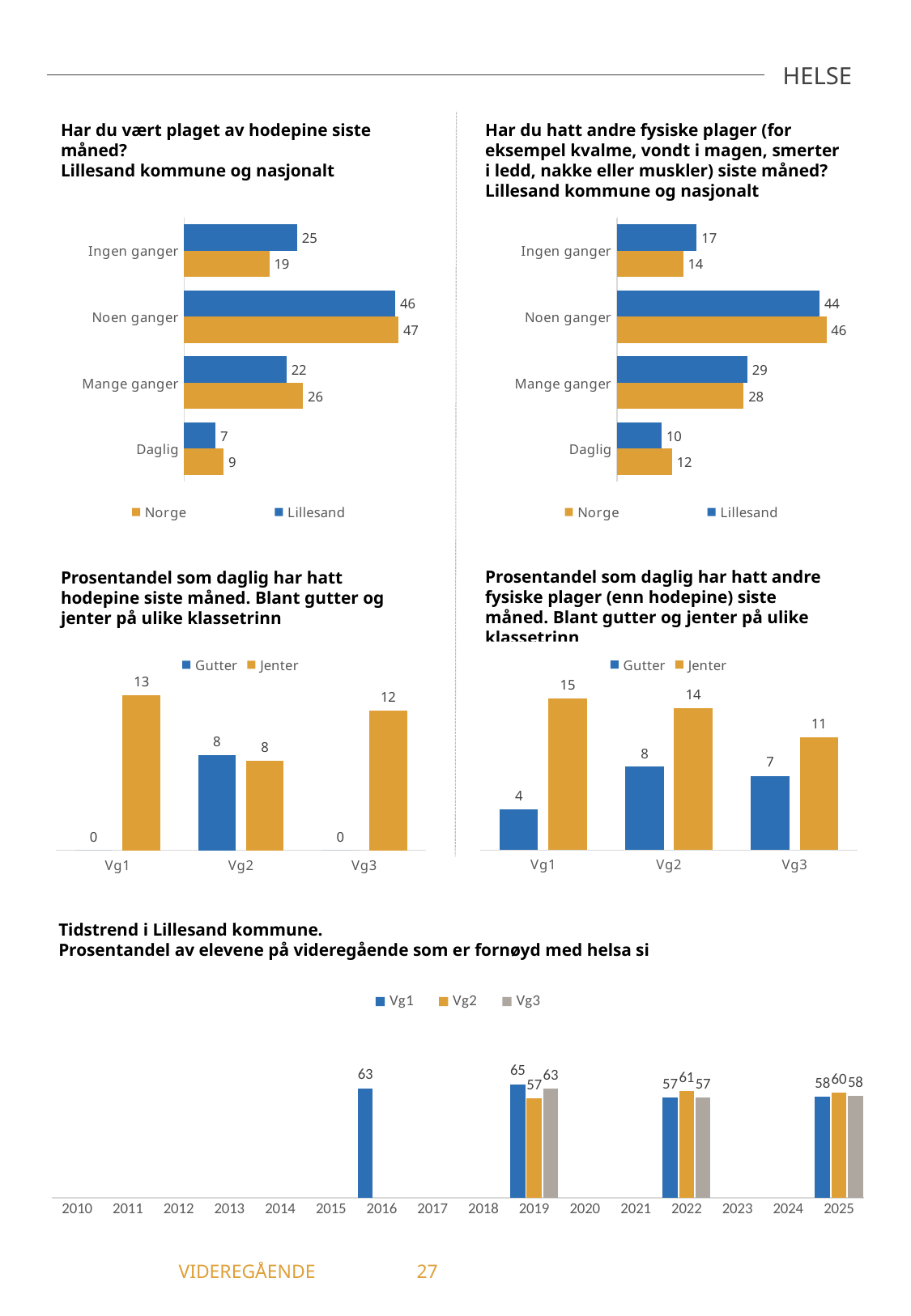
In the middle-right chart 'Prosentandel som daglig har hatt andre fysiske plager', what is the difference between Jenter and Gutter at Vg2? 6 In the top-left chart 'Har du vært plaget av hodepine siste måned?', what is the value for Lillesand in the 'Noen ganger' category? 46 In the middle-right chart 'Prosentandel som daglig har hatt andre fysiske plager', which class level has the lowest value for Gutter? Vg1 In the middle-left chart 'Prosentandel som daglig har hatt hodepine siste måned', what is the value for Jenter at Vg1? 13 In the middle-left chart 'Prosentandel som daglig har hatt hodepine siste måned', how many series does the legend list? 2 What kind of chart is the bottom chart 'Tidstrend i Lillesand kommune'? bar chart In the top-right chart 'Har du hatt andre fysiske plager...', what is the value for Norge in the 'Daglig' category? 12 In the bottom chart 'Tidstrend i Lillesand kommune', how many series does the legend list? 3 In the top-left chart 'Har du vært plaget av hodepine siste måned?', what is the difference between the Norge and Lillesand values for 'Mange ganger'? 4 In the top-right chart 'Har du hatt andre fysiske plager...', is the Lillesand value for 'Ingen ganger' larger or smaller than the Norge value? larger In the top-right chart 'Har du hatt andre fysiske plager...', which category has the highest value for Lillesand? Noen ganger In the bottom chart 'Tidstrend i Lillesand kommune', what is the value for Vg2 in 2022? 61